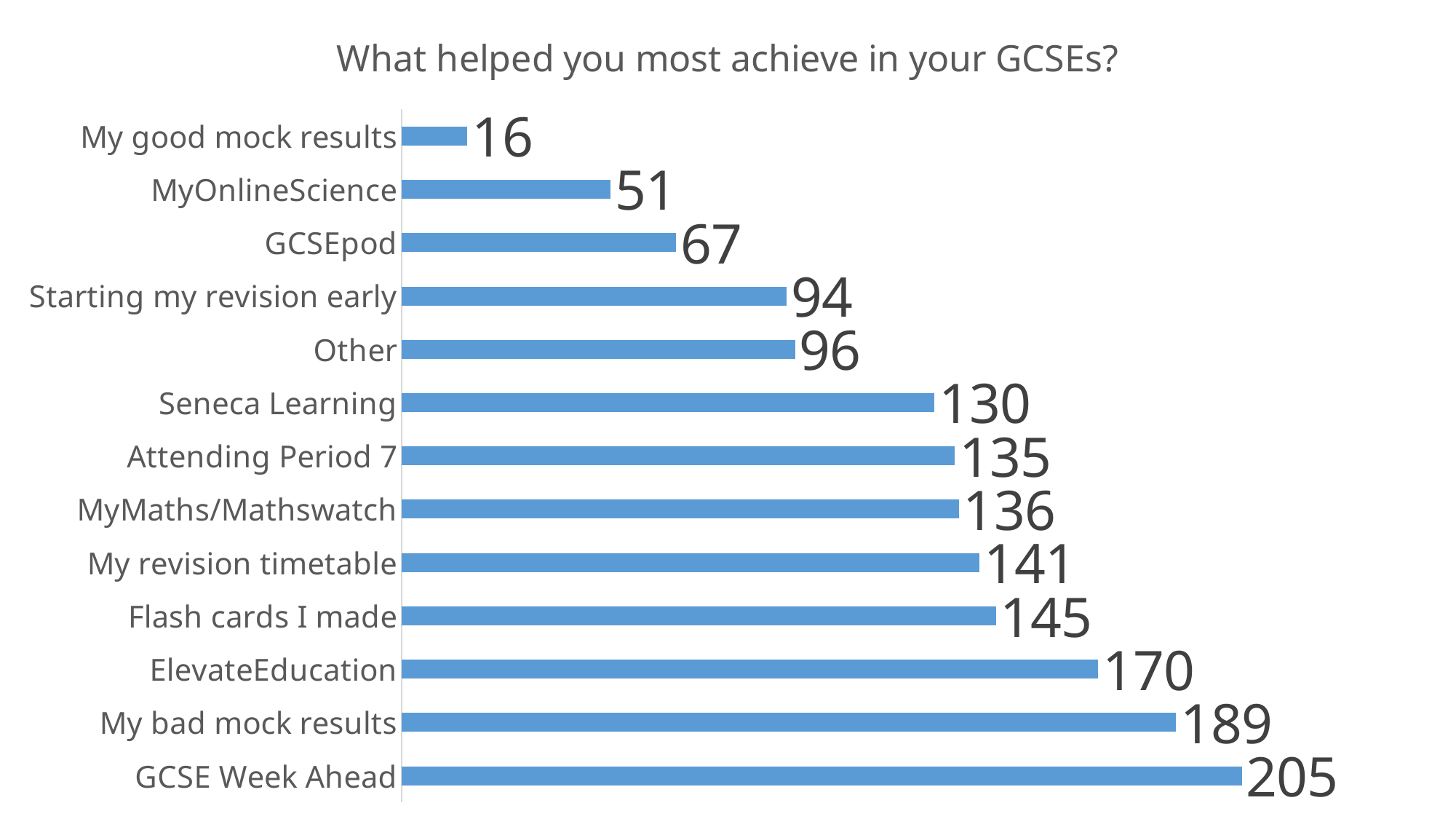
Which category has the lowest value? My good mock results What value is shown for GCSE Week Ahead? 205 What value is shown for Starting my revision early? 94 How many categories are shown in the chart? 13 Which category has the highest value? GCSE Week Ahead Which is larger, the value for GCSEpod or the value for MyOnlineScience? GCSEpod What is the difference between the values for My bad mock results and My good mock results? 173 What kind of chart is shown on the slide? Bar chart What value is shown for Seneca Learning? 130 What is the title of the chart? What helped you most achieve in your GCSEs? What is the difference between the values for ElevateEducation and Flash cards I made? 25 Which is larger, the value for Other or the value for Seneca Learning? Seneca Learning